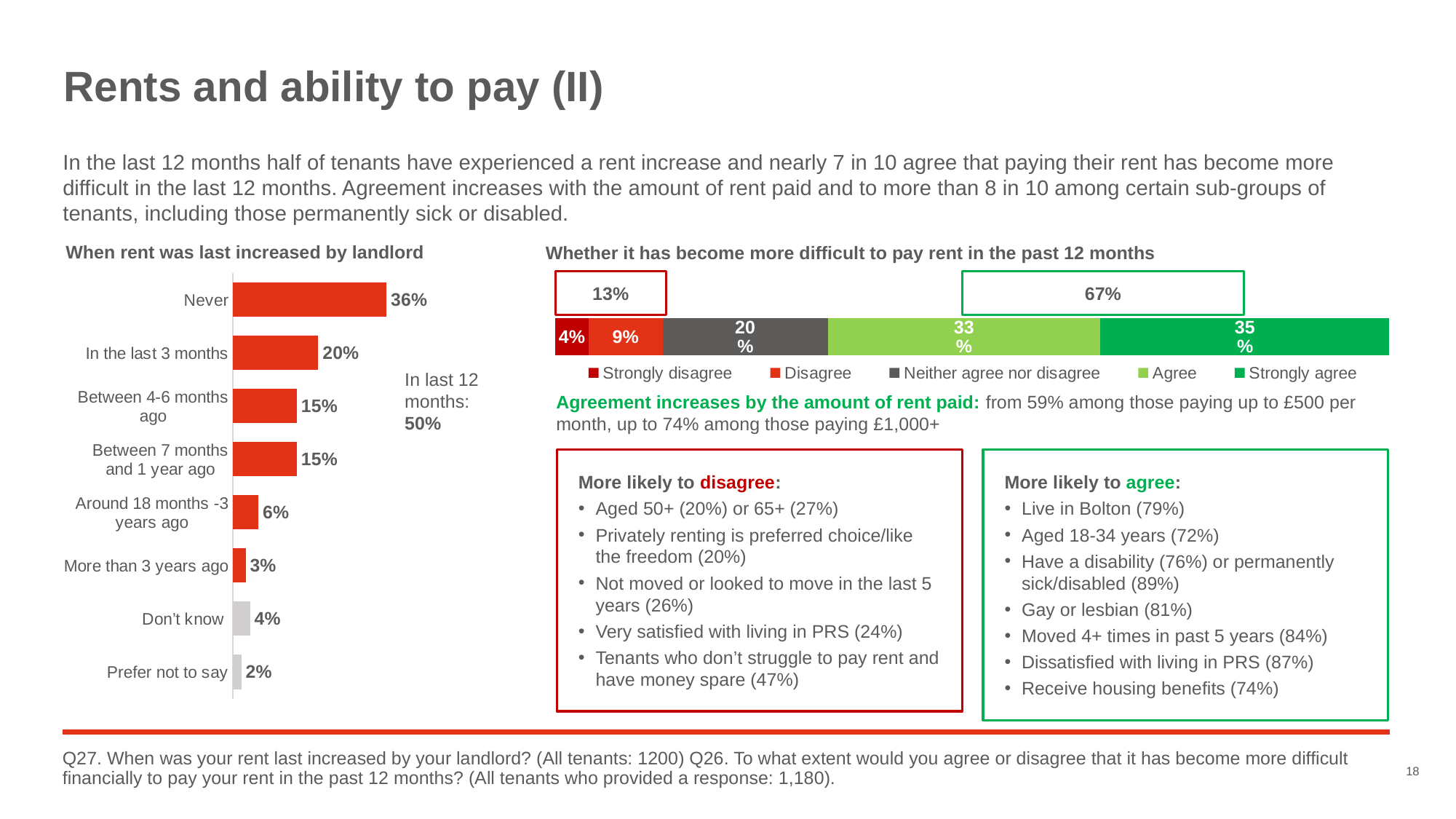
In the 'When rent was last increased by landlord' chart, what is the difference between 'Never' and 'In the last 3 months'? 16% In the 'When rent was last increased by landlord' chart, which is larger: 'Around 18 months -3 years ago' or 'Don't know'? Around 18 months -3 years ago What kind of chart is 'When rent was last increased by landlord'? Bar chart In the 'Whether it has become more difficult to pay rent in the past 12 months' chart, what is the value for 'Neither agree nor disagree'? 20% In the 'When rent was last increased by landlord' chart, what is the value for 'In the last 3 months'? 20% In the 'Whether it has become more difficult to pay rent in the past 12 months' chart, what is the combined total of 'Agree' and 'Strongly agree'? 68% In the 'When rent was last increased by landlord' chart, what is the value for 'Never'? 36% How many categories are shown in the 'When rent was last increased by landlord' chart? 8 In the 'Whether it has become more difficult to pay rent in the past 12 months' chart, what is the value for 'Strongly agree'? 35% In the 'When rent was last increased by landlord' chart, which category has the lowest value? Prefer not to say How many series does the legend list in the 'Whether it has become more difficult to pay rent in the past 12 months' chart? 5 In the 'When rent was last increased by landlord' chart, which category has the highest value? Never